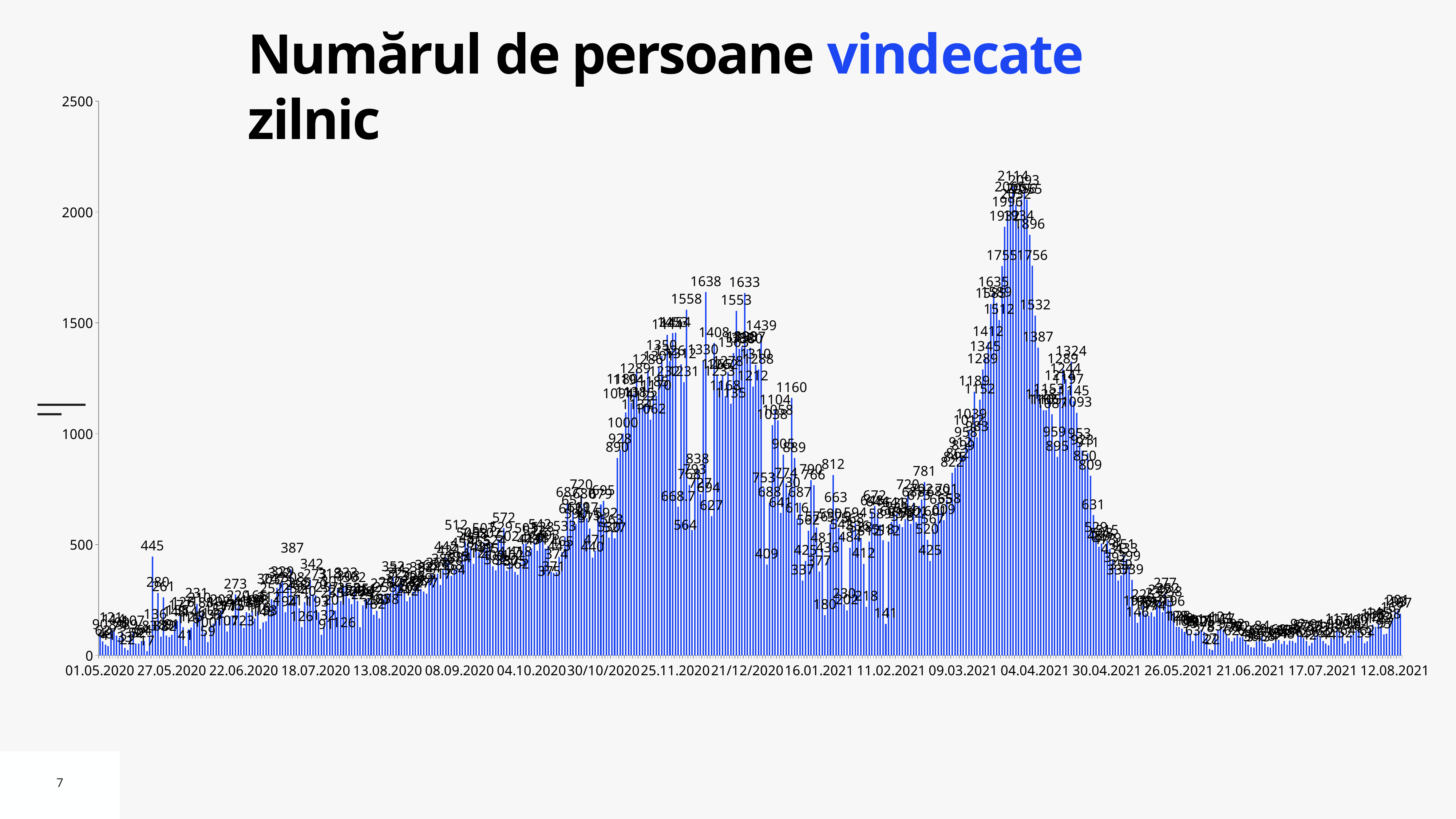
Do the values rise or fall between 04.04.2021 and 26.05.2021? fall What is the title of the chart? Numărul de persoane vindecate zilnic What is the last date shown on the horizontal axis? 12.08.2021 Are the values around 12.08.2021 greater or less than 500? less Which is larger: the peak around 04.04.2021 or the peak around 25.11.2020? the peak around 04.04.2021 What is the highest daily value labelled on the chart? 2114 Is the peak value of the chart greater or less than 2000? greater What kind of chart is shown on the slide? bar chart Are the values around 21.06.2021 greater or less than 500? less Do the values rise or fall between 09.03.2021 and 04.04.2021? rise What is the first date shown on the horizontal axis? 01.05.2020 What is the maximum value shown on the vertical axis? 2500